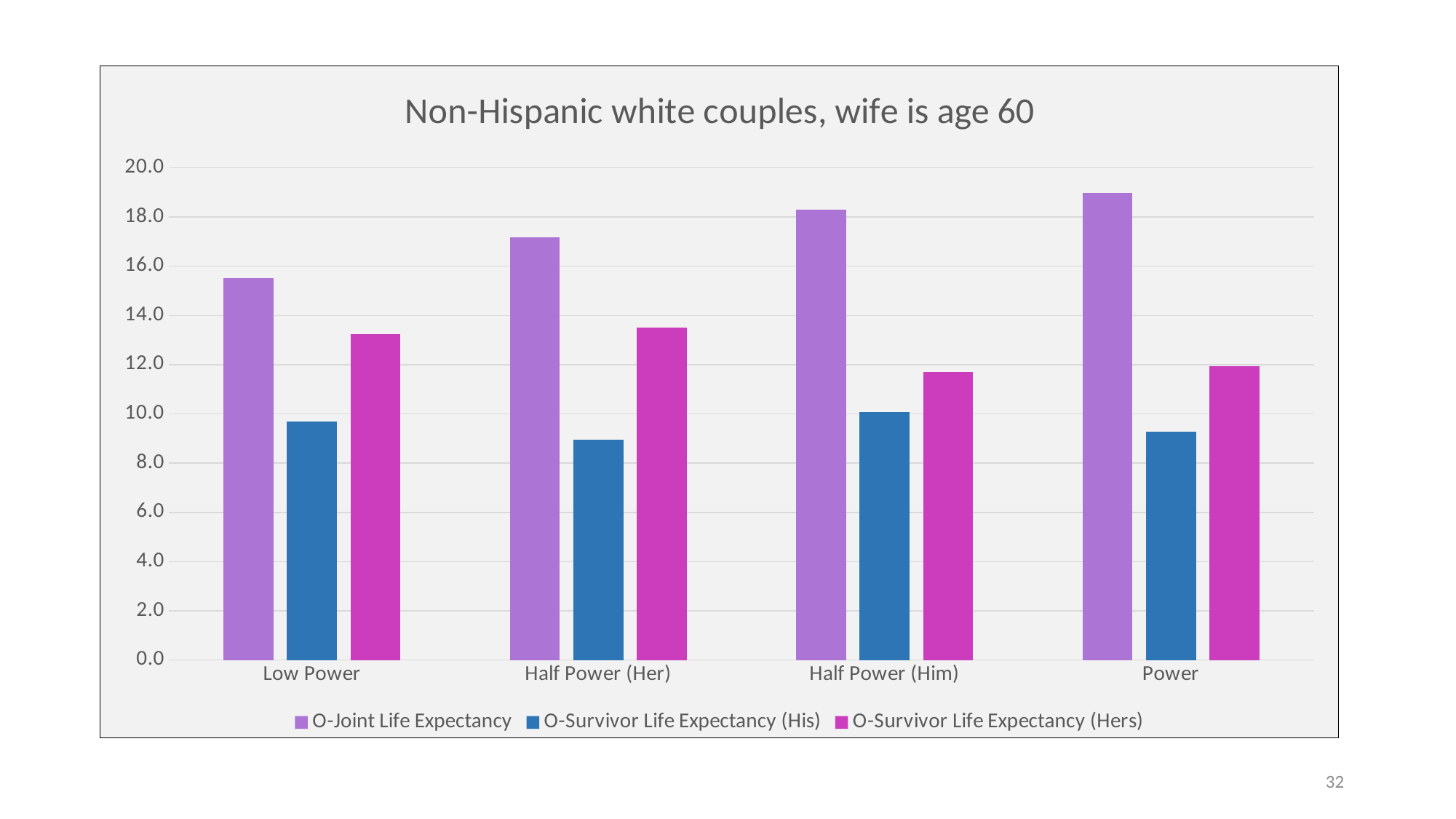
Is the O-Survivor Life Expectancy (His) for Half Power (Her) greater or less than 10.0? less Is the O-Joint Life Expectancy for Power greater or less than 18.0? greater What is the title of the chart? Non-Hispanic white couples, wife is age 60 For Low Power, which is larger: O-Joint Life Expectancy or O-Survivor Life Expectancy (Hers)? O-Joint Life Expectancy Does O-Joint Life Expectancy rise or fall moving from Low Power to Power along the x axis? rise Is the O-Joint Life Expectancy for Low Power greater or less than 14.0? greater How many series does the legend list? 3 What kind of chart is shown on the slide? bar chart How many categories are shown on the x axis? 4 Which category has the highest O-Joint Life Expectancy? Power Which category has the lowest O-Joint Life Expectancy? Low Power For Half Power (Him), which is larger: O-Survivor Life Expectancy (His) or O-Survivor Life Expectancy (Hers)? O-Survivor Life Expectancy (Hers)